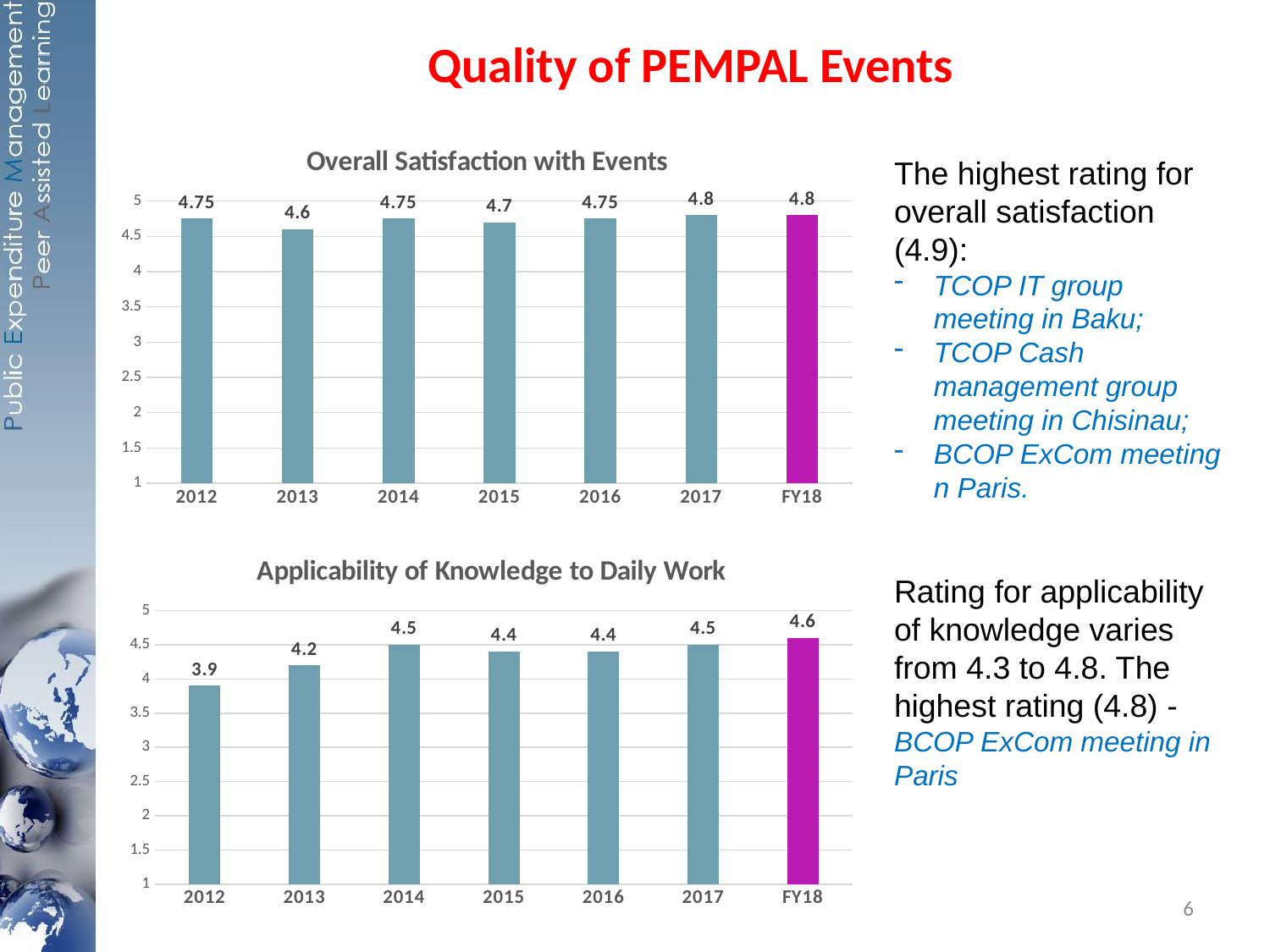
In the 'Overall Satisfaction with Events' chart, how many bars are plotted? 7 In the 'Applicability of Knowledge to Daily Work' chart, which year has the lowest value? 2012 In the 'Applicability of Knowledge to Daily Work' chart, which year has the highest value? FY18 In the 'Applicability of Knowledge to Daily Work' chart, what is the difference between the FY18 value and the 2012 value? 0.7 In the 'Applicability of Knowledge to Daily Work' chart, is the value for 2012 greater or less than 4? less What type of chart is the 'Applicability of Knowledge to Daily Work' chart? bar chart In the 'Overall Satisfaction with Events' chart, what is the difference between the 2017 value and the 2013 value? 0.2 In the 'Applicability of Knowledge to Daily Work' chart, is the value for 2013 larger or smaller than the value for 2014? smaller In the 'Applicability of Knowledge to Daily Work' chart, what is the value for 2012? 3.9 In the 'Overall Satisfaction with Events' chart, what is the value for FY18? 4.8 In the 'Overall Satisfaction with Events' chart, which year has the lowest value? 2013 In the 'Overall Satisfaction with Events' chart, what is the value for 2013? 4.6